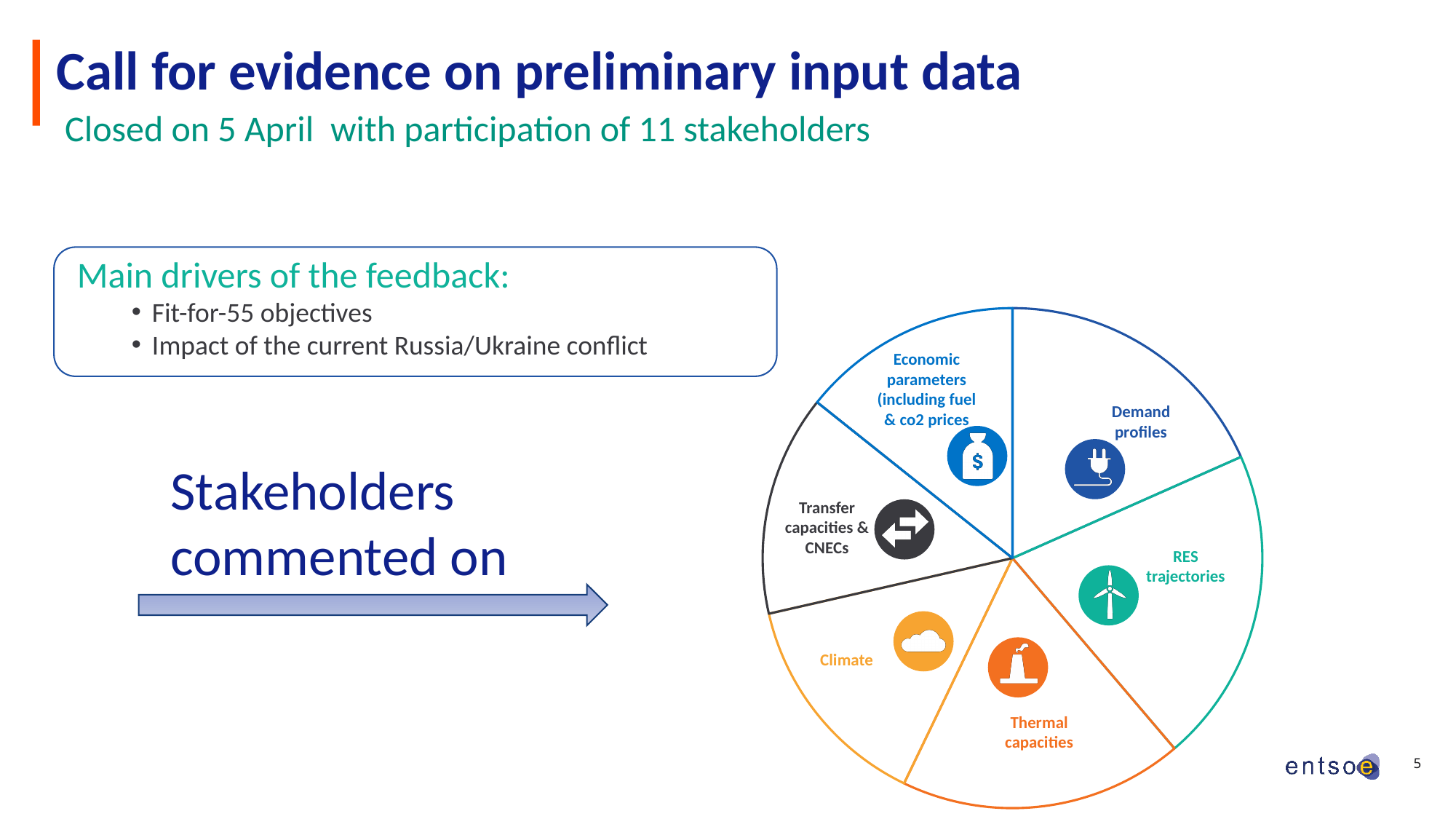
Which slice of the pie chart is larger, RES trajectories or Transfer capacities & CNECs? RES trajectories How many slices does the pie chart have? 6 Which slice of the pie chart is labelled with a wind turbine icon? RES trajectories What kind of chart is shown on the slide? pie chart